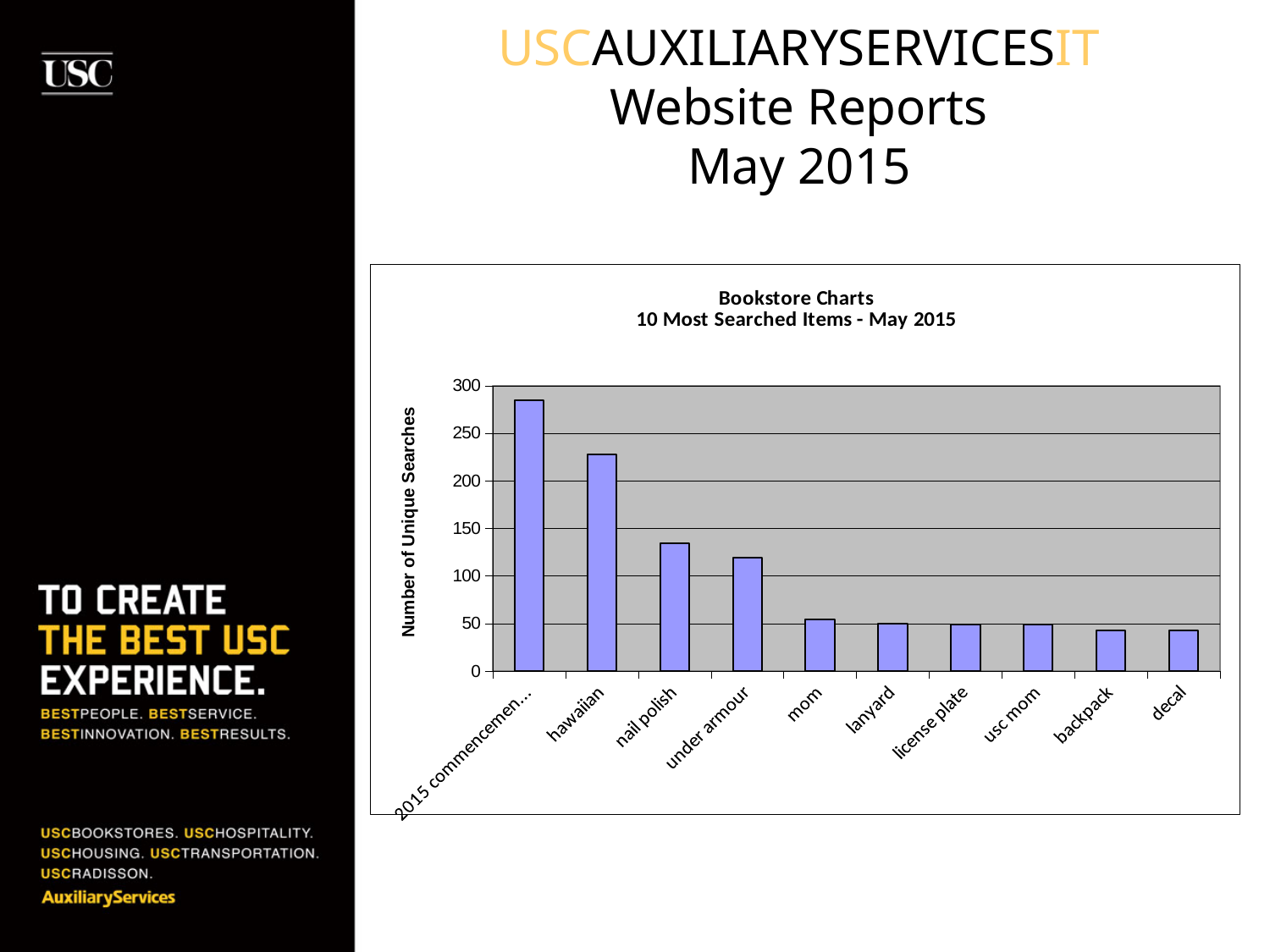
Which has more unique searches, under armour or mom? under armour Which has more unique searches, hawaiian or nail polish? hawaiian Is the value for lanyard greater or less than 100? less What is the label on the vertical axis of the chart? Number of Unique Searches Is the value for nail polish greater or less than 100? greater Is the value for under armour greater or less than 150? less What kind of chart is shown on the slide? bar chart What is the title of the chart? Bookstore Charts 10 Most Searched Items - May 2015 How many categories are plotted on the x axis of the chart? 10 Do the values generally rise or fall from left to right along the x axis? fall